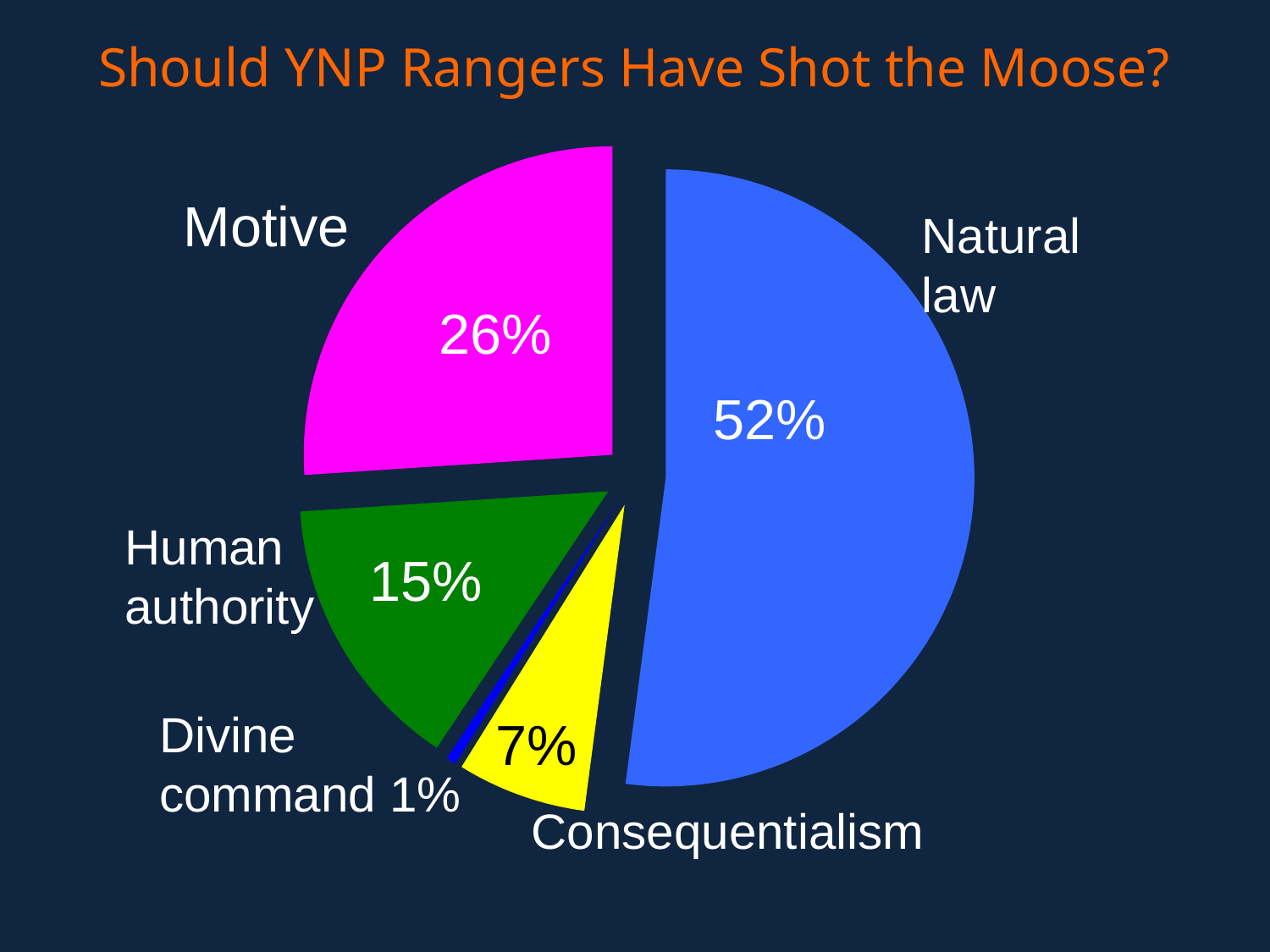
What share of the pie does Human authority have? 15% How many categories are shown in the pie chart? 5 Which category has the smallest slice of the pie? Divine command What share of the pie does Divine command have? 1% Which category has the largest slice of the pie? Natural law What is the difference in percentage points between Natural law and Motive? 26 Which is larger, the slice for Motive or the slice for Human authority? Motive What kind of chart is shown on the slide? Pie chart What share of the pie does Natural law have? 52% What is the difference in percentage points between Human authority and Consequentialism? 8 What share of the pie does Consequentialism have? 7% What share of the pie does Motive have? 26%